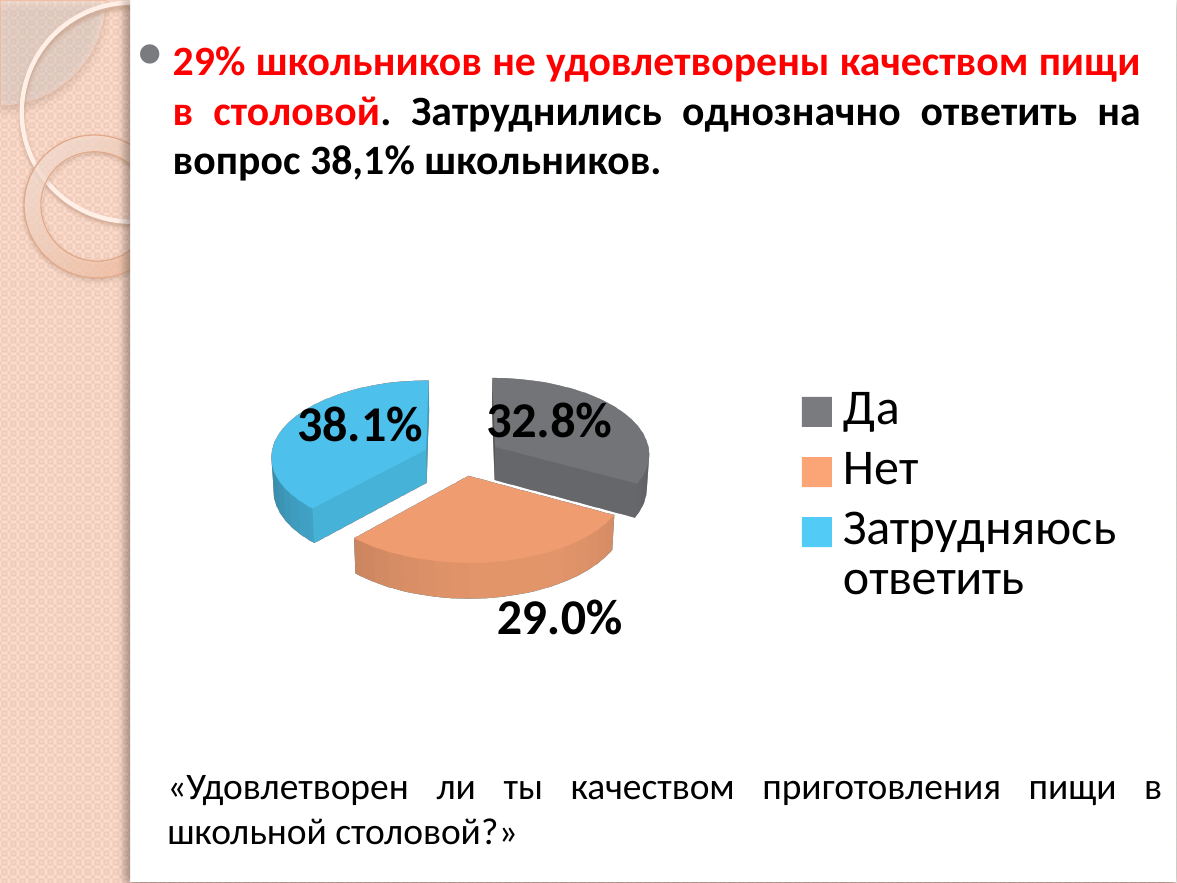
Which category has the largest slice of the pie? Затрудняюсь ответить What is the difference between the "Затрудняюсь ответить" share and the "Нет" share? 9.1% Which is larger: the "Да" slice or the "Нет" slice? Да What is the difference between the "Да" share and the "Нет" share? 3.8% What percentage of the pie corresponds to "Да"? 32.8% What kind of chart is shown on the slide? pie chart What colour is the "Затрудняюсь ответить" slice? blue How many entries does the legend list? 3 What percentage of the pie corresponds to "Затрудняюсь ответить"? 38.1% How many slices does the pie chart have? 3 What percentage of the pie corresponds to "Нет"? 29.0% Which category has the smallest slice of the pie? Нет